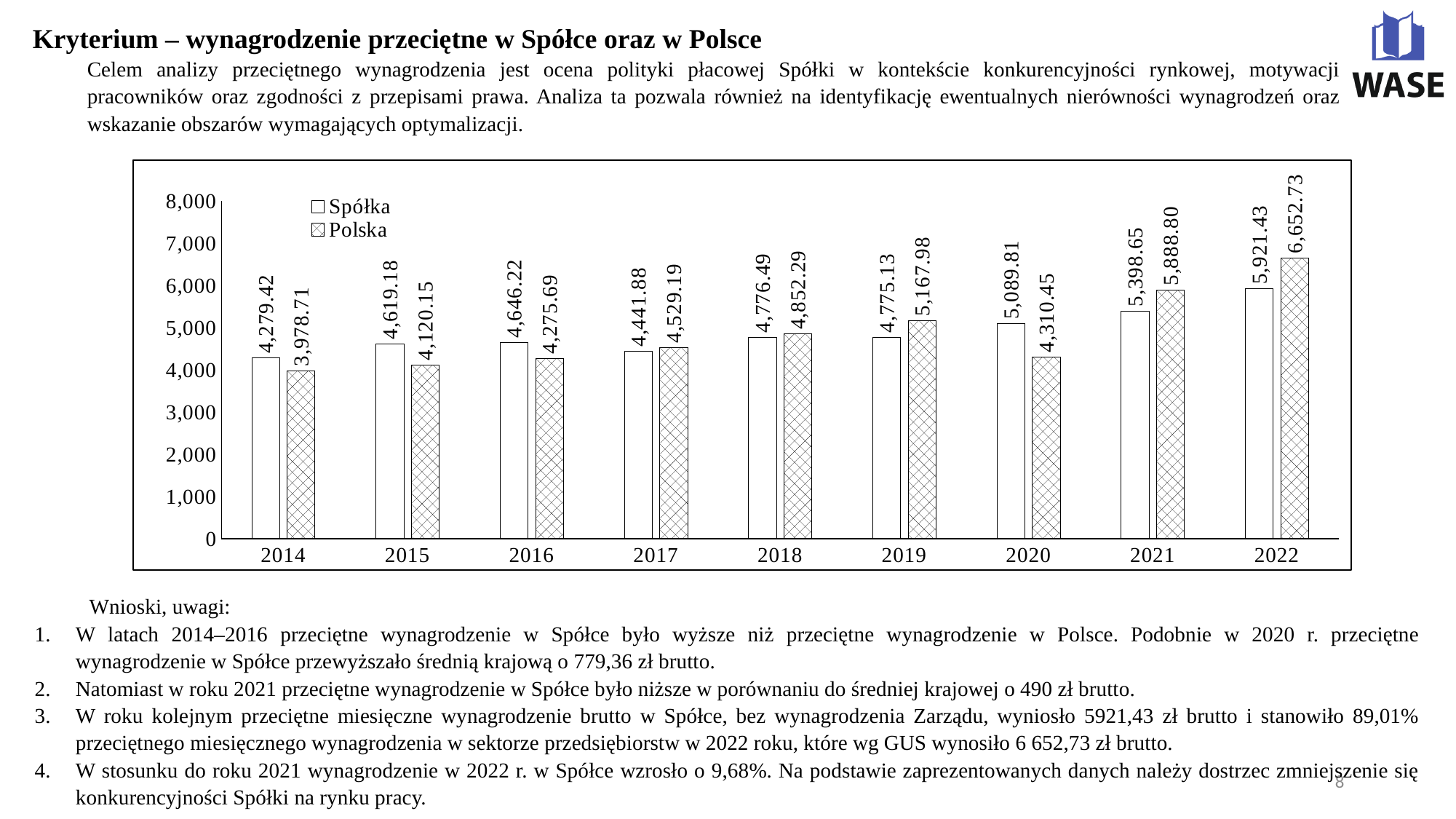
In 2021, which is larger: the Spółka value or the Polska value? Polska How many years are shown on the x axis? 9 What kind of chart is shown on the slide? Bar chart What is the value for Spółka in 2022? 5,921.43 What is the difference between the Spółka and Polska values in 2020? 779.36 How many series does the legend list? 2 In which year is the Spółka value lowest? 2014 Do the Polska values rise or fall from 2020 to 2022? Rise What is the value for Polska in 2014? 3,978.71 In which year is the Polska value highest? 2022 What is the value for Polska in 2019? 5,167.98 What is the difference between the Polska and Spółka values in 2022? 731.30